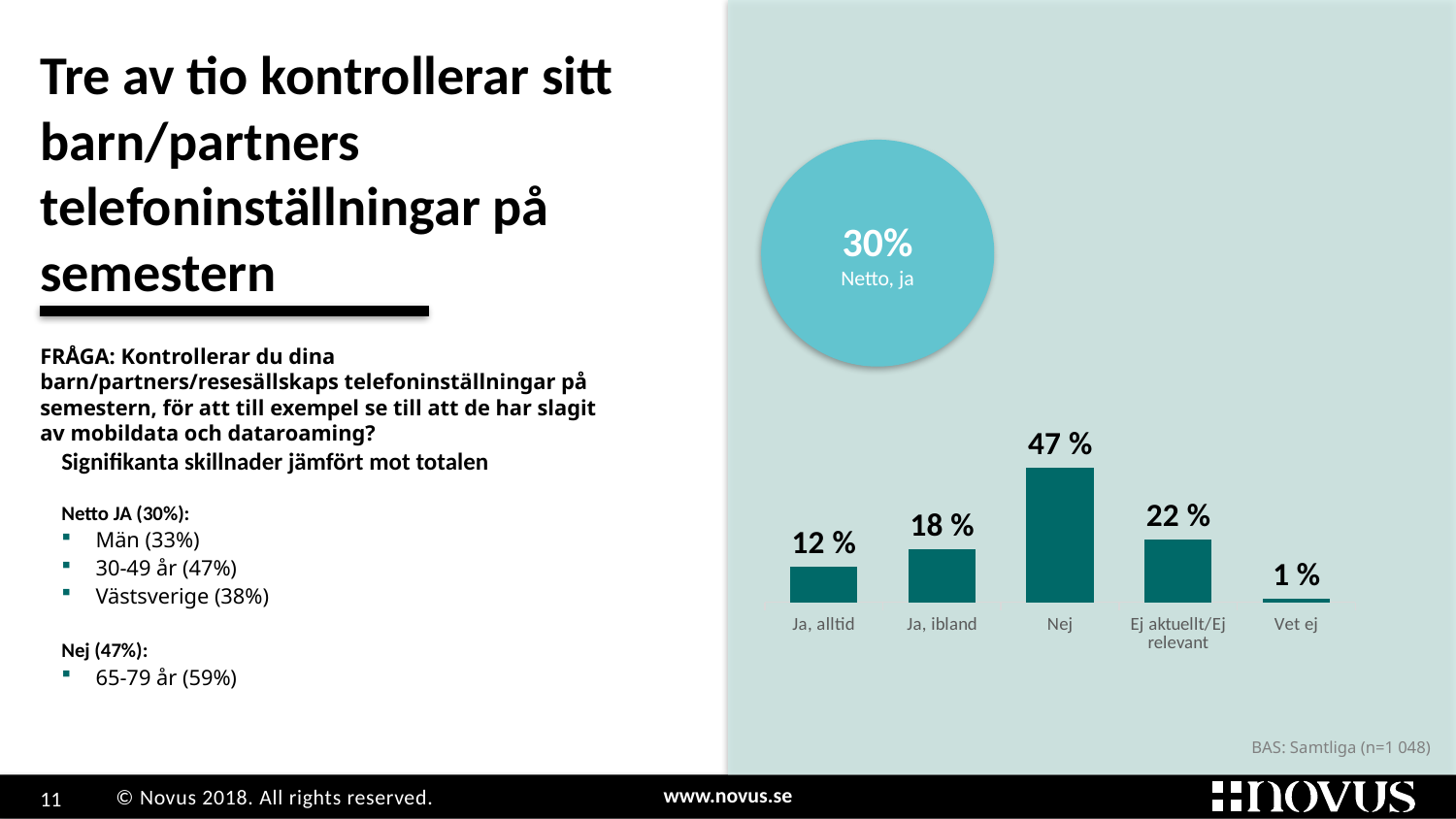
What is the value for "Ja, ibland"? 18 % What value is shown in the circle labelled "Netto, ja"? 30% What is the combined value of "Ja, alltid" and "Ja, ibland"? 30 % What is the difference between "Nej" and "Ej aktuellt/Ej relevant"? 25 % What kind of chart is shown on the slide? Bar chart How many categories are shown in the bar chart? 5 Which category has the highest value? Nej What is the value for "Nej"? 47 % Which category has the lowest value? Vet ej What is the value for "Ja, alltid"? 12 % Which is larger, "Ja, ibland" or "Ja, alltid"? Ja, ibland What is the value for "Ej aktuellt/Ej relevant"? 22 %